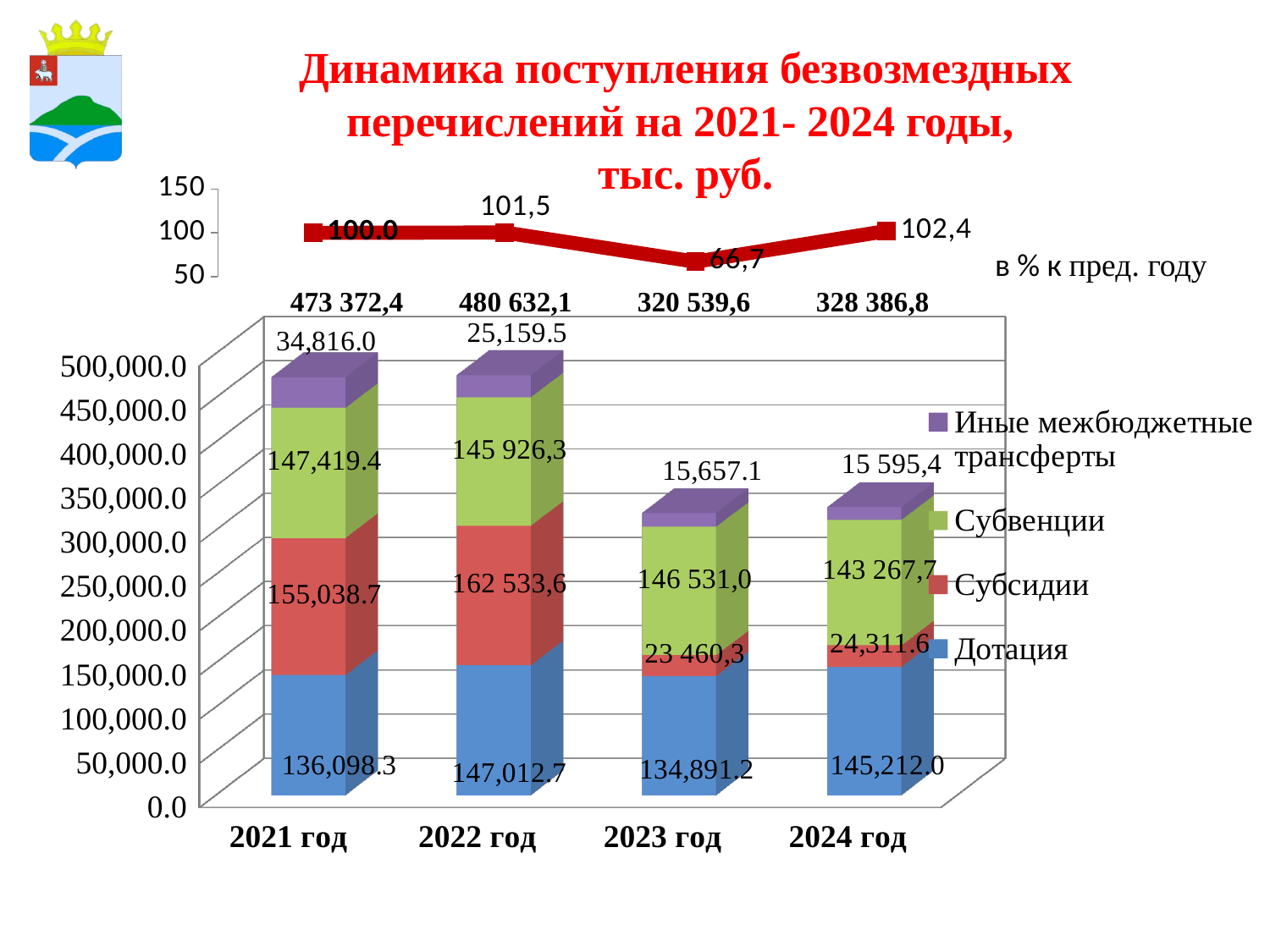
What is the total of the stacked bar for 2024 год? 328 386,8 What is the value of Субсидии for 2022 год? 162 533,6 What is the value of Дотация for 2021 год? 136,098.3 What is the value of Иные межбюджетные трансферты for 2023 год? 15,657.1 In 2021 год, which is larger: Субсидии or Субвенции? Субсидии How many series does the legend of the stacked bar chart list? 4 What is the percentage to the previous year (в % к пред. году) shown for 2023 год? 66,7 Which year has the highest total of безвозмездные перечисления? 2022 год Which year has the lowest total of безвозмездные перечисления? 2023 год What is the value of Субвенции for 2024 год? 143 267,7 By how much did Дотация increase from 2021 год to 2022 год? 10,914.4 What kind of chart shows the breakdown by Дотация, Субсидии, Субвенции and Иные межбюджетные трансферты? Stacked bar chart